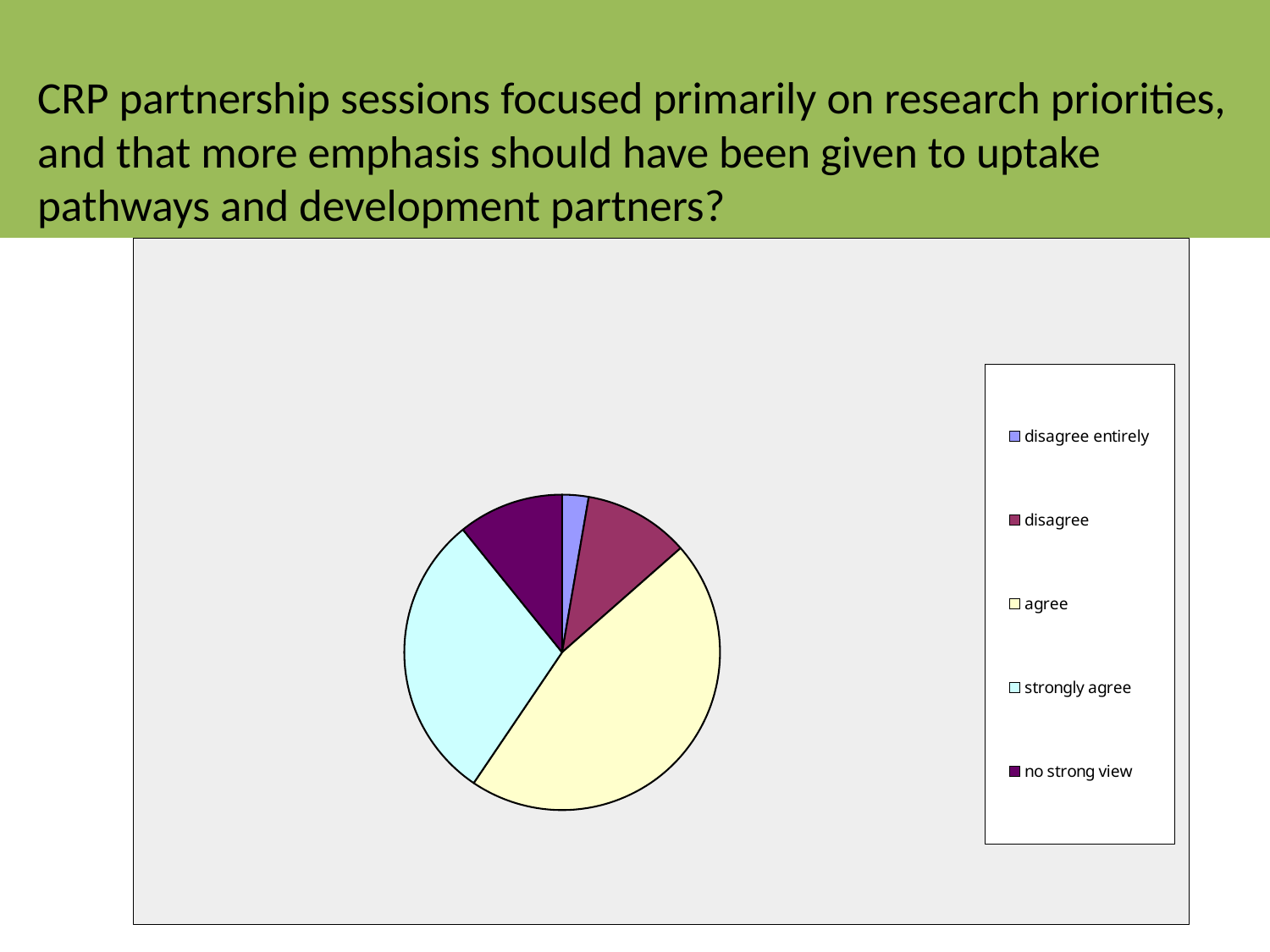
Which category has the smallest slice of the pie chart? disagree entirely Which category has the largest slice of the pie chart? agree Which legend entry is shown in light yellow? agree How many slices does the pie chart have? 5 How many entries does the legend of the pie chart list? 5 What kind of chart is shown on the slide? pie chart Which slice is larger, disagree entirely or strongly agree? strongly agree Which slice is larger, no strong view or agree? agree Which slice is larger, agree or strongly agree? agree Which legend entry is listed first in the legend? disagree entirely Which category has the second-largest slice of the pie chart? strongly agree